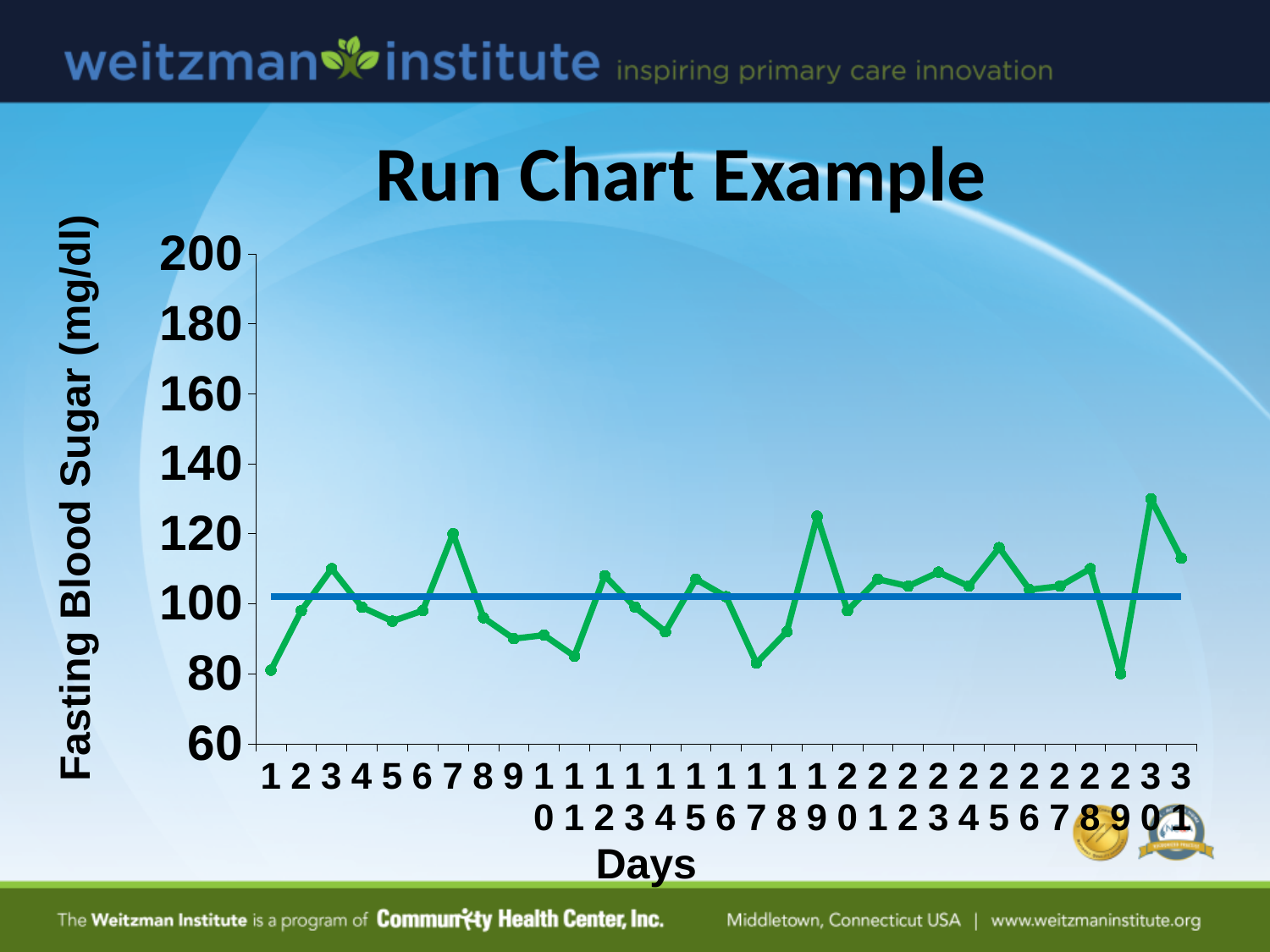
On which day is the fasting blood sugar highest? 30 Is the value for day 30 greater or less than 120? greater Which day has the larger value, day 29 or day 30? 30 What is the title of the chart? Run Chart Example Which day has the larger value, day 18 or day 19? 19 Is the value for day 29 greater or less than 100? less What is the label of the vertical axis? Fasting Blood Sugar (mg/dl) Is the value for day 1 greater or less than 100? less What kind of chart is shown on the slide? line chart How many days are plotted on the x axis? 31